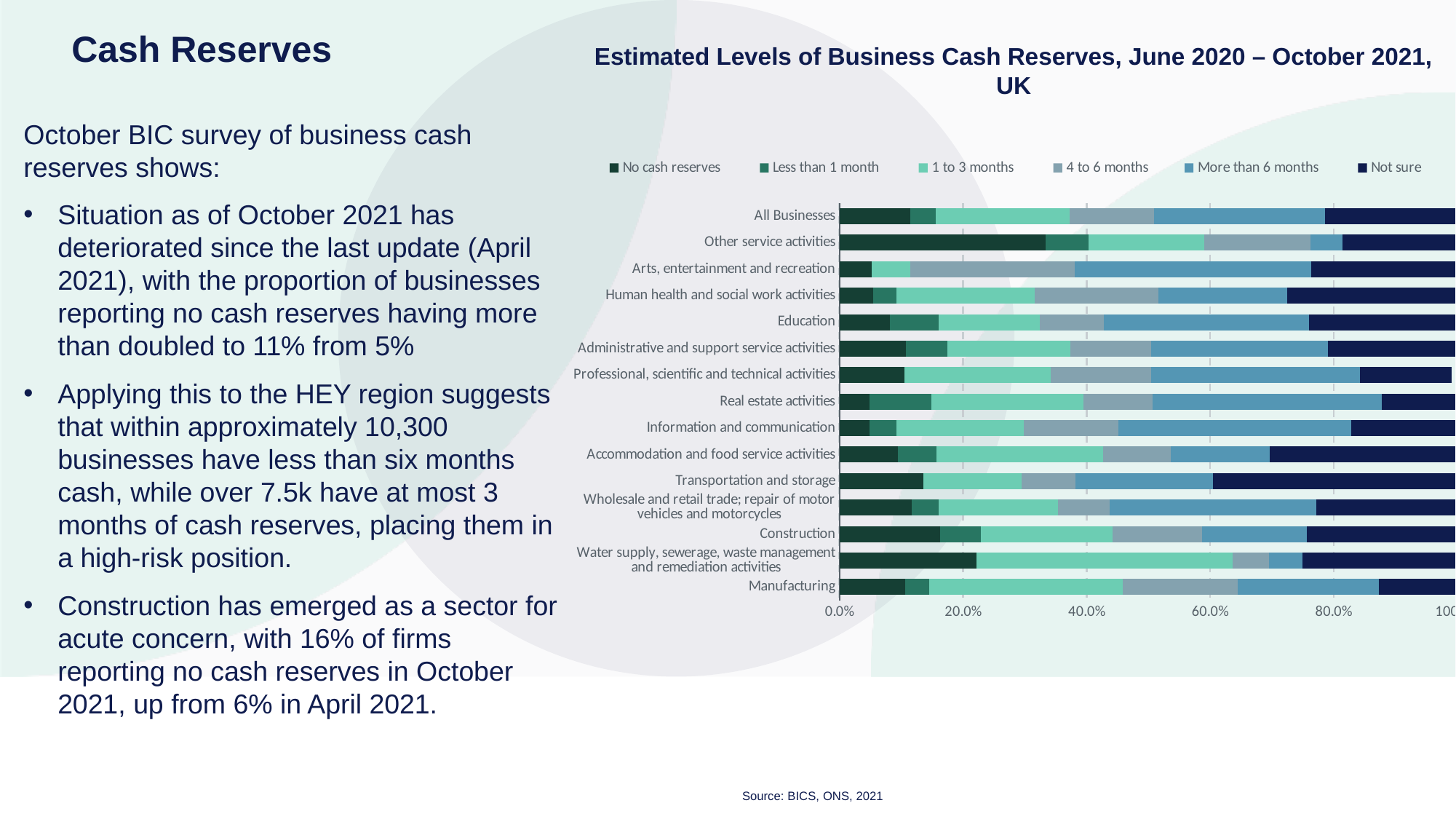
Which legend entry is listed first in the chart legend? No cash reserves How many business categories are plotted on the chart? 15 Is the 'No cash reserves' value for Arts, entertainment and recreation greater or less than 20%? less Which category has the largest 'No cash reserves' segment? Other service activities Which has the larger 'No cash reserves' segment: Other service activities or Arts, entertainment and recreation? Other service activities Is the 'No cash reserves' value for Other service activities greater or less than 20%? greater Which category has the largest 'Not sure' segment? Transportation and storage What is the title of the chart? Estimated Levels of Business Cash Reserves, June 2020 – October 2021, UK According to the slide, what proportion of Construction firms reported no cash reserves in October 2021? 16% How many series does the chart legend list? 6 What kind of chart is shown on the slide? Stacked bar chart